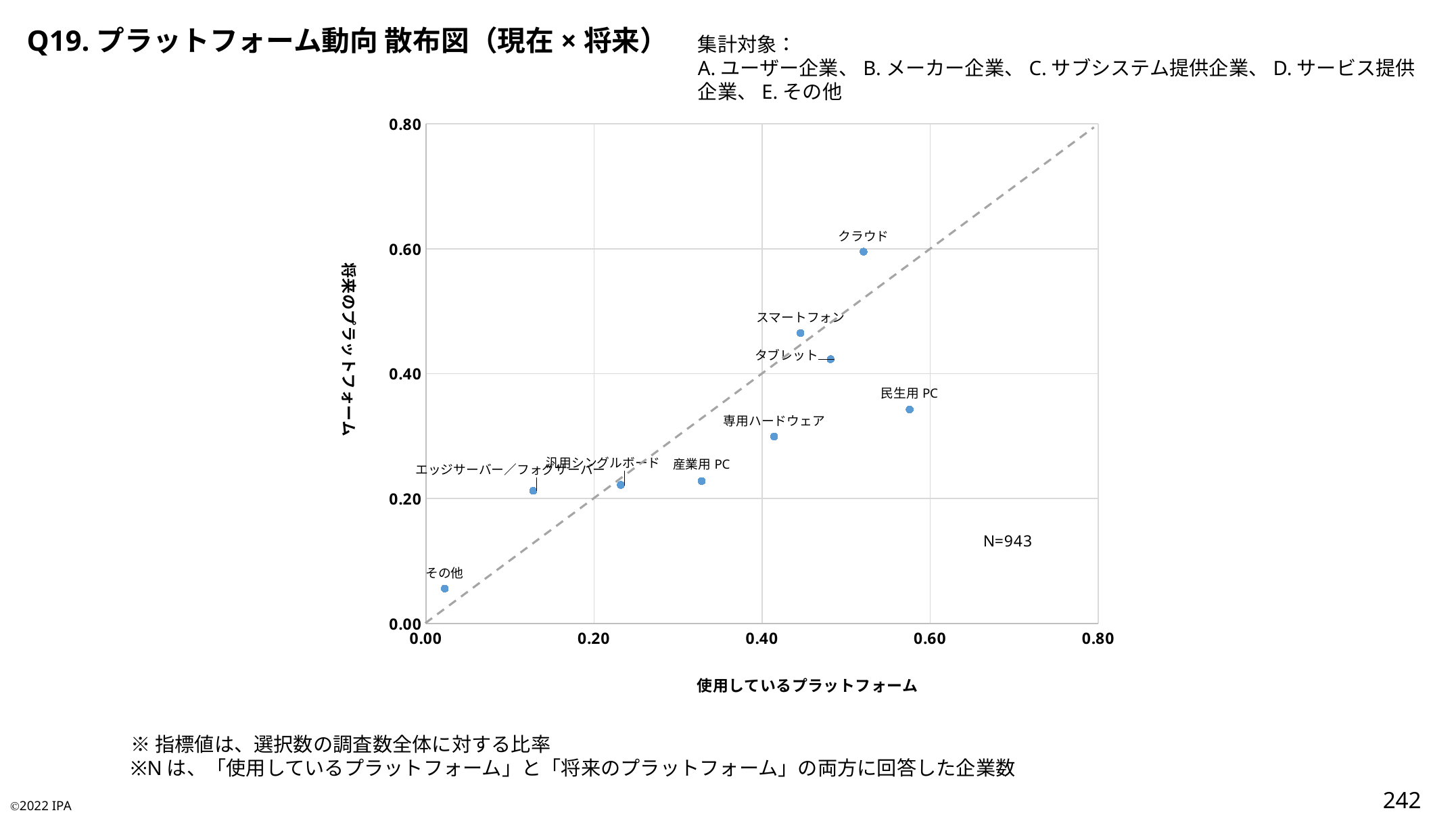
Which platform has the highest value on the vertical axis (将来のプラットフォーム)? クラウド What is the N value shown on the chart? N=943 Which platform has the highest value on the horizontal axis (使用しているプラットフォーム)? 民生用 PC What is the label of the horizontal axis? 使用しているプラットフォーム Is the horizontal-axis value for 民生用 PC greater or less than 0.40? greater Is the vertical-axis value for その他 greater or less than 0.20? less How many data points are plotted in the scatter chart? 9 Which has the larger vertical-axis value, クラウド or 民生用 PC? クラウド What kind of chart is shown on the slide? scatter chart Which platform has the lowest value on the horizontal axis (使用しているプラットフォーム)? その他 Is the horizontal-axis value for エッジサーバー／フォグサーバー greater or less than 0.20? less